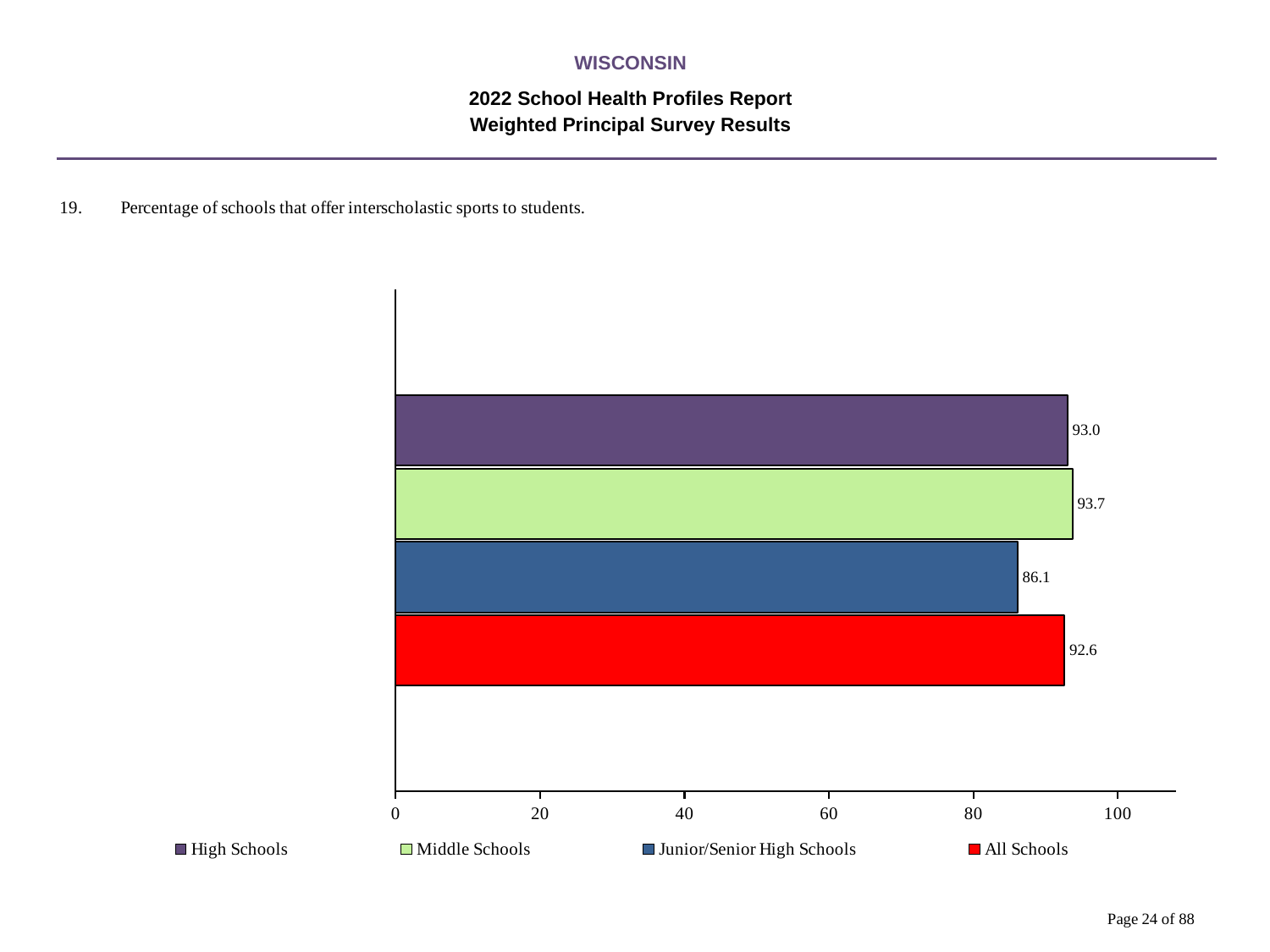
How many entries does the legend list? 4 Which is larger, the value for High Schools or the value for Junior/Senior High Schools? High Schools What is the difference between the values for High Schools and All Schools? 0.4 What is the value for Junior/Senior High Schools? 86.1 Which category has the lowest value? Junior/Senior High Schools What is the value for High Schools? 93.0 What is the value for All Schools? 92.6 What is the value for Middle Schools? 93.7 What is the difference between the values for Middle Schools and Junior/Senior High Schools? 7.6 What kind of chart is shown on the slide? Bar chart How many bars are shown in the chart? 4 Which category has the highest value? Middle Schools